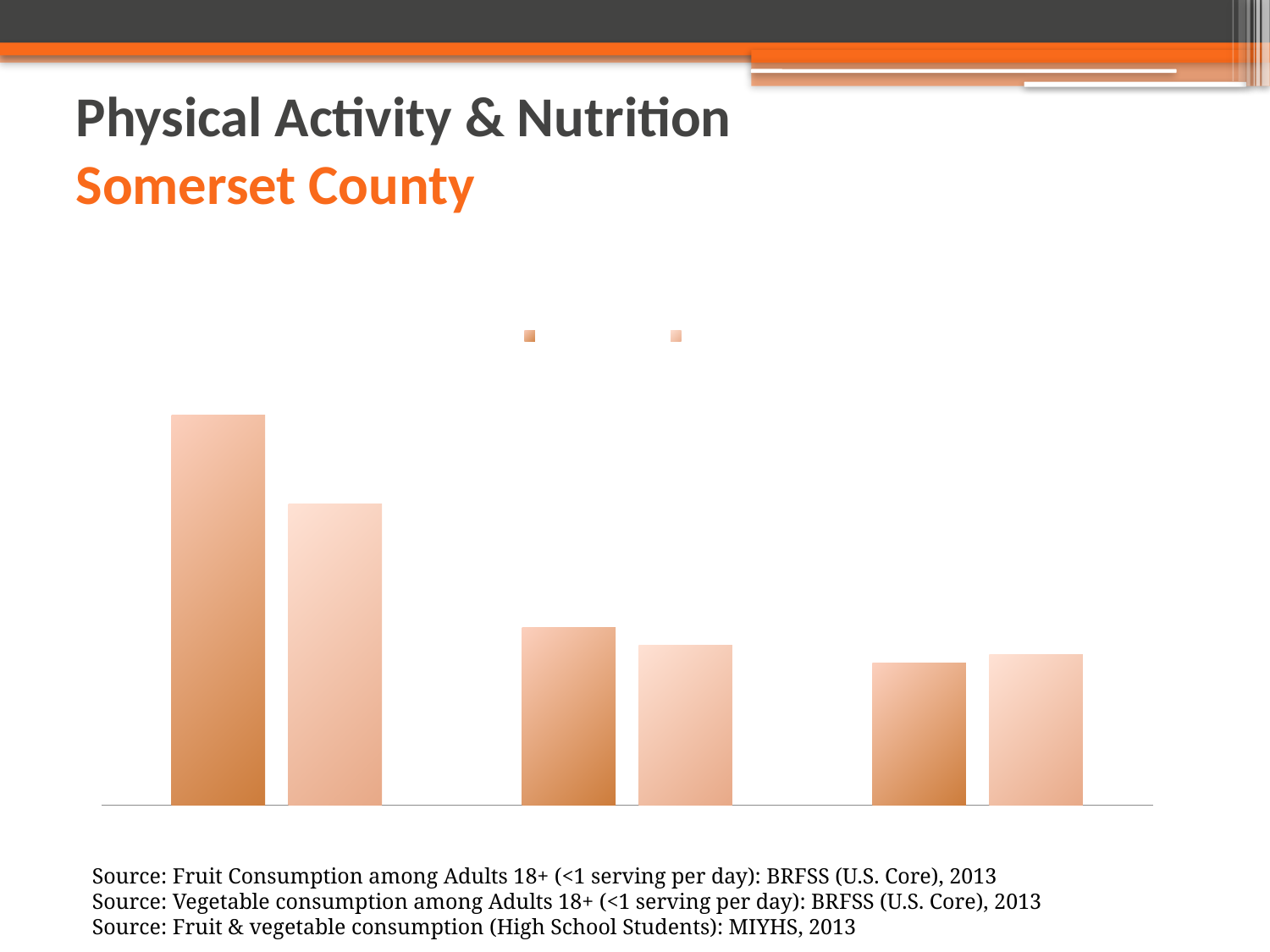
In the leftmost group of bars, which series has the larger value, the darker-orange or the lighter-orange? darker-orange In the rightmost group of bars, which series has the larger value, the darker-orange or the lighter-orange? lighter-orange Which group of bars, by position, contains the tallest bar in the chart? leftmost group Do the values of the lighter-orange series rise or fall from left to right across the groups? fall How many groups of bars are plotted in the chart? 3 How many series does the legend list? 2 Which group of bars, by position, contains the shortest bar in the chart? rightmost group What kind of chart is shown on the slide? bar chart How many bars are plotted in the chart in total? 6 What colour are the bars in the chart? orange Do the values of the darker-orange series rise or fall from left to right across the groups? fall